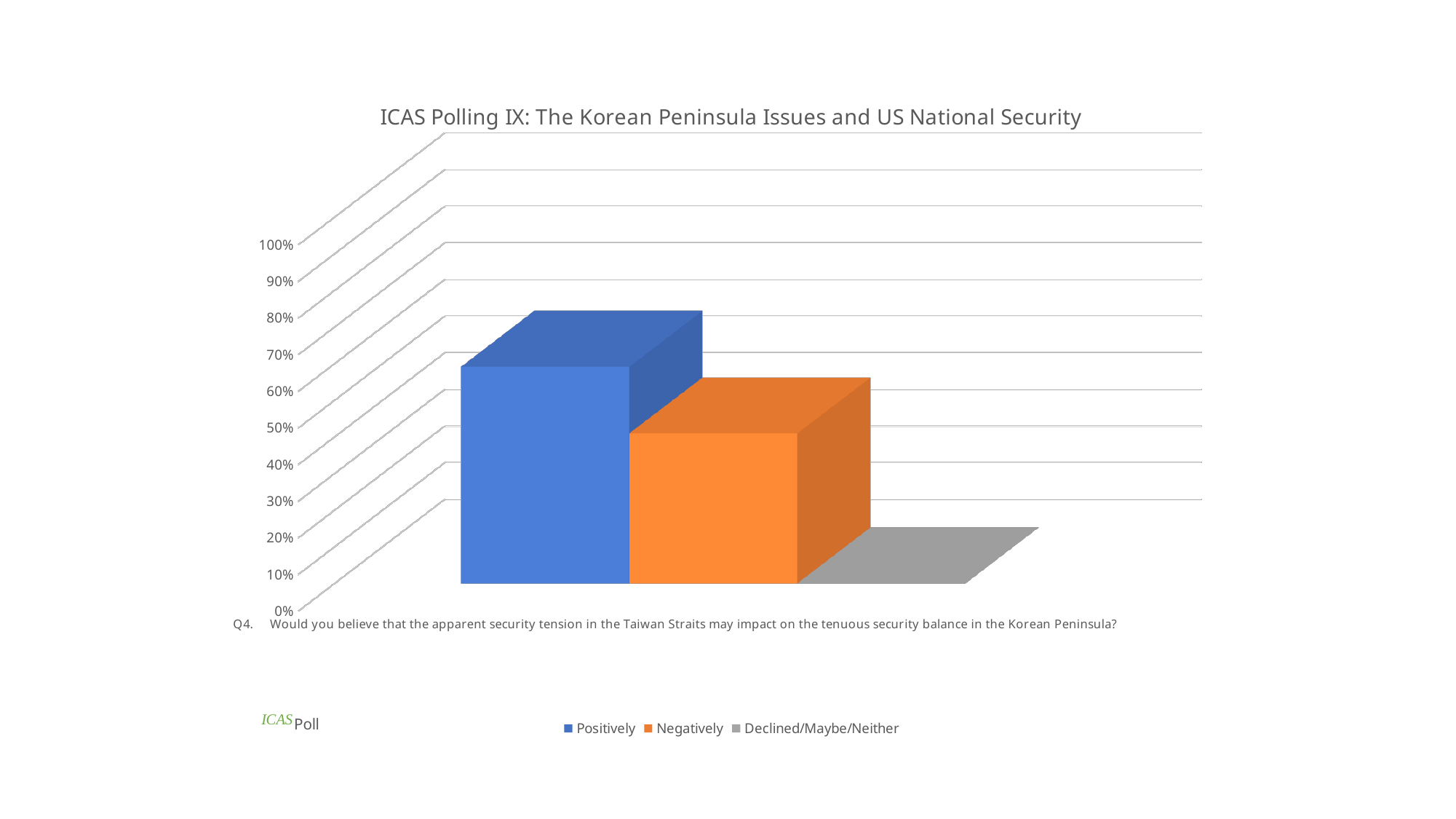
Which is larger, the value for Positively or the value for Negatively? Positively Which response has the highest value? Positively Which is larger, the value for Negatively or the value for Declined/Maybe/Neither? Negatively Is the value for Negatively greater or less than 50%? less Is the value for Declined/Maybe/Neither greater or less than 10%? less What kind of chart is shown on the slide? Bar chart Which colour represents the Negatively series in the legend? Orange What is the title of the chart? ICAS Polling IX: The Korean Peninsula Issues and US National Security How many series does the legend list? 3 Is the value for Negatively greater or less than 30%? greater Which response has the lowest value? Declined/Maybe/Neither